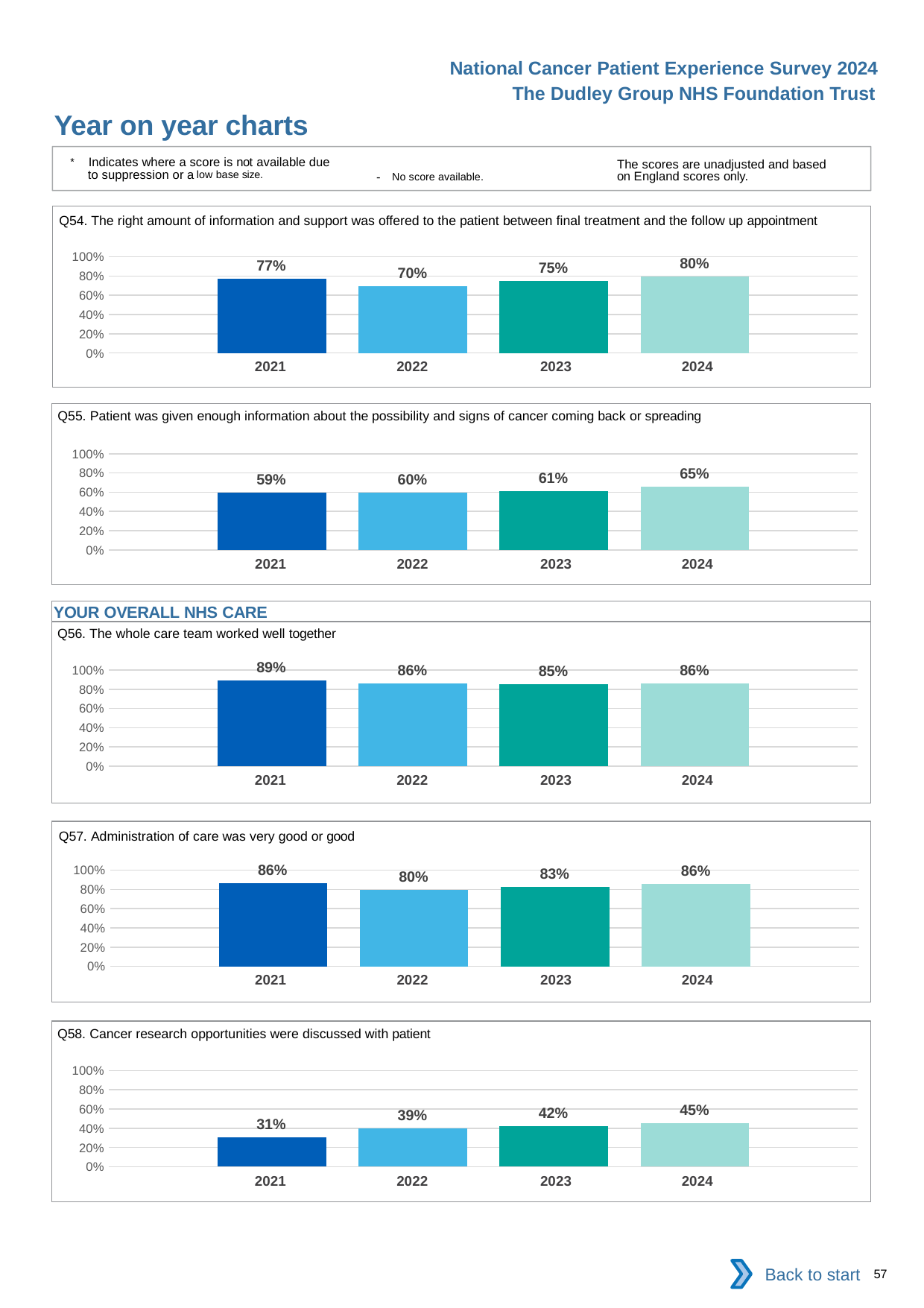
In the Q56 chart, which year has the lowest value? 2023 In the Q54 chart, what is the value for 2022? 70% In the Q58 chart, is the value for 2024 greater or less than 40%? greater In the Q55 chart, do the values rise or fall from 2021 to 2024? rise How many years are shown in the Q58 chart? 4 In the Q57 chart, what is the difference between the 2021 and 2022 values? 6 percentage points In the Q56 chart, what is the value for 2021? 89% In the Q58 chart, what is the value for 2021? 31% What kind of chart is the Q54 chart? bar chart In the Q54 chart, which year has the highest value? 2024 In the Q55 chart, what is the difference between the 2024 and 2021 values? 6 percentage points In the Q57 chart, which is larger, the value for 2022 or the value for 2023? 2023